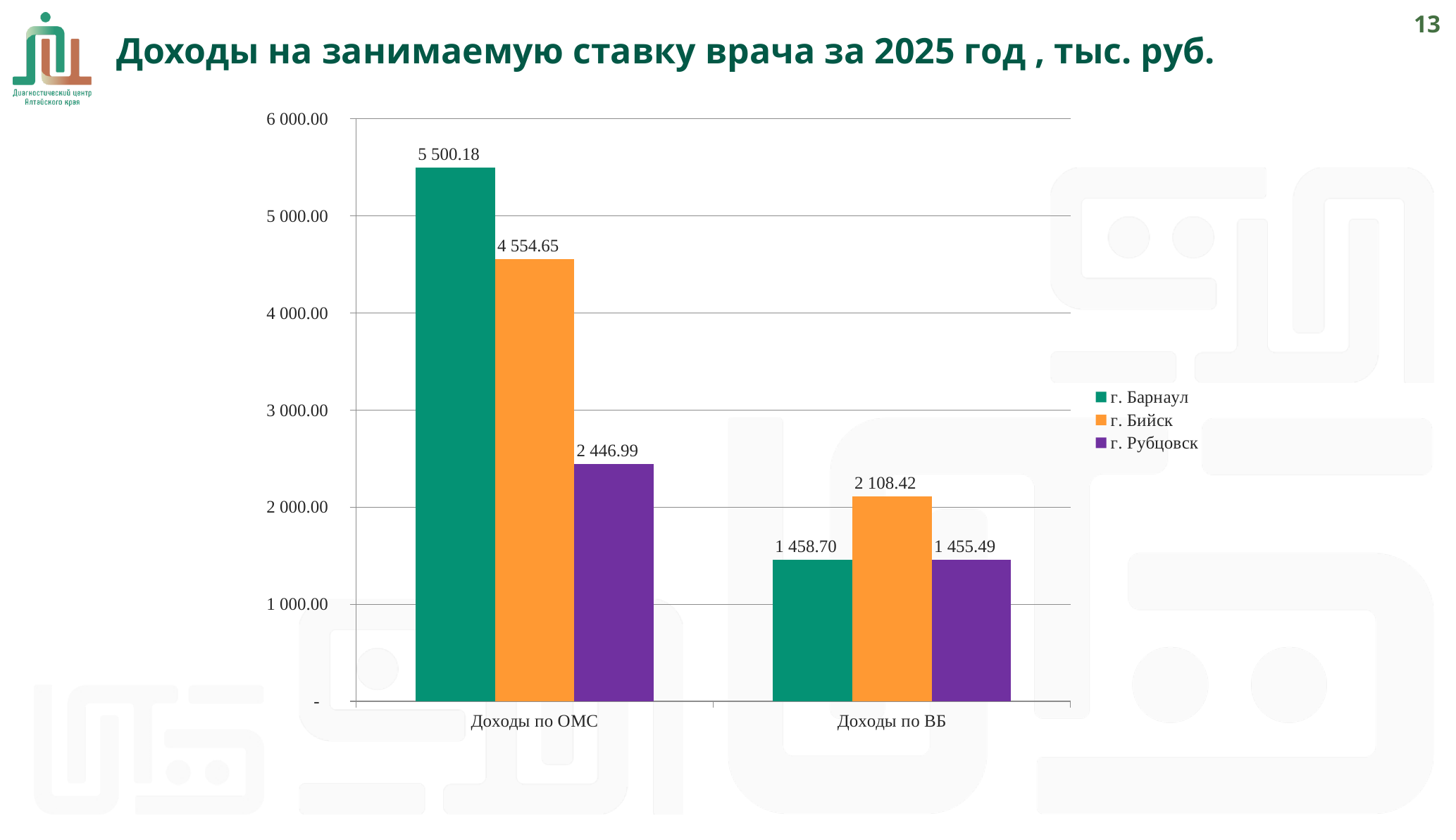
Is the value for г. Рубцовск in Доходы по ОМС greater or less than 2 000.00? greater Which city has the lowest value in the Доходы по ВБ category? г. Рубцовск What is the difference between г. Бийск and г. Барнаул in the Доходы по ВБ category? 649.72 What type of chart is shown on the slide? bar chart How many categories are shown on the x axis? 2 What is the value for г. Рубцовск in the Доходы по ОМС category? 2 446.99 How many series does the legend list? 3 What is the difference between г. Барнаул and г. Бийск in the Доходы по ОМС category? 945.53 Which is larger: г. Бийск in Доходы по ОМС or г. Бийск in Доходы по ВБ? г. Бийск in Доходы по ОМС What is the value for г. Бийск in the Доходы по ВБ category? 2 108.42 What is the value for г. Барнаул in the Доходы по ОМС category? 5 500.18 Which city has the highest value in the Доходы по ОМС category? г. Барнаул